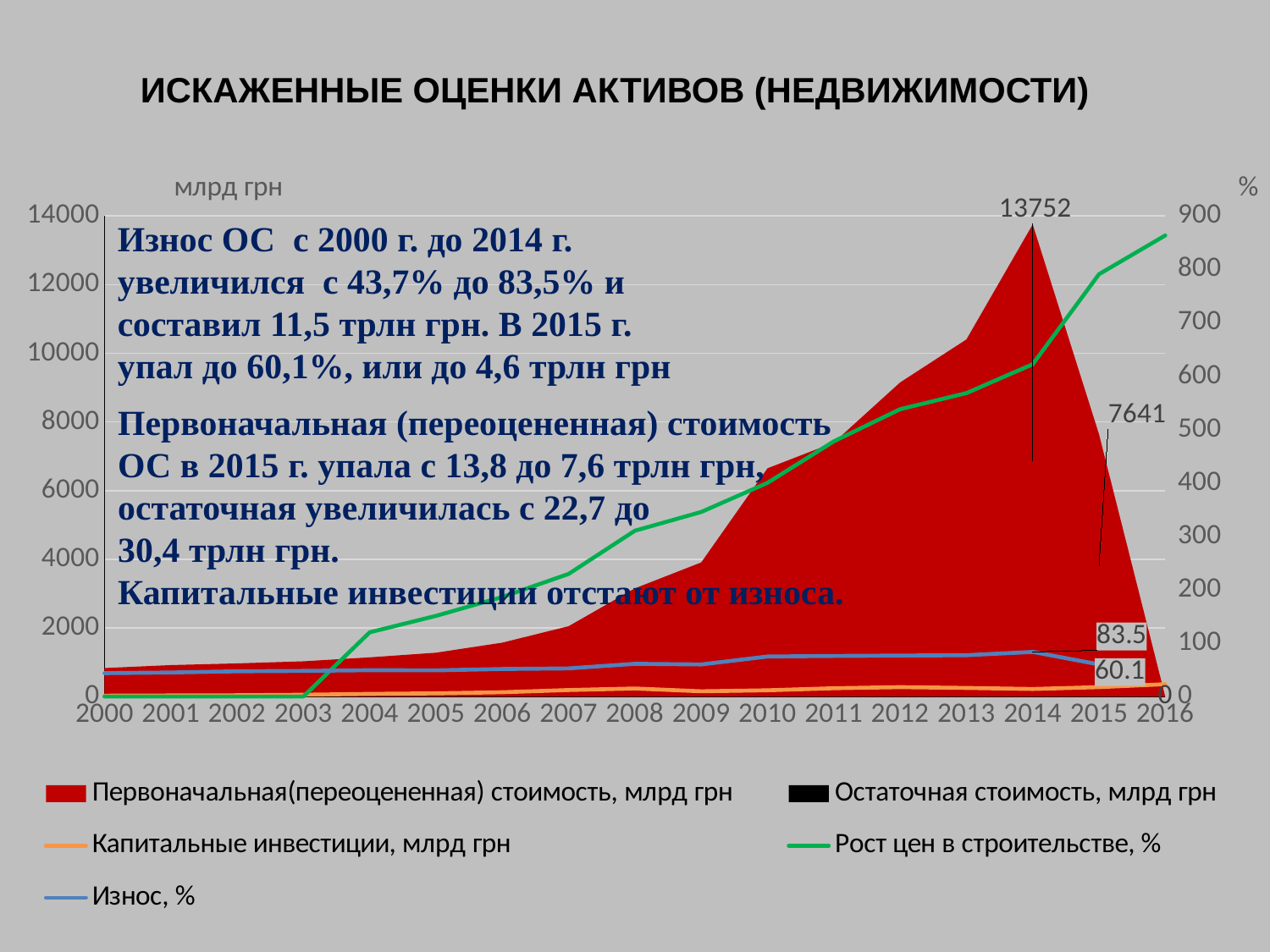
What is the value of Первоначальная(переоцененная) стоимость in 2014? 13752 What is the value of Первоначальная(переоцененная) стоимость in 2015? 7641 What is the difference between Износ, % in 2014 and in 2015? 23.4 Which year has the highest Первоначальная(переоцененная) стоимость? 2014 Is the value of Рост цен в строительстве, % in 2016 greater or less than 800? greater What is the value of Износ, % in 2014? 83.5 By how much did Первоначальная(переоцененная) стоимость fall from 2014 to 2015? 6111 How many years are shown on the x axis? 17 How many series does the legend list? 5 What is the value of Износ, % in 2015? 60.1 Which is larger, Первоначальная(переоцененная) стоимость in 2014 or in 2015? 2014 Does Рост цен в строительстве, % rise or fall from 2000 to 2016? rises